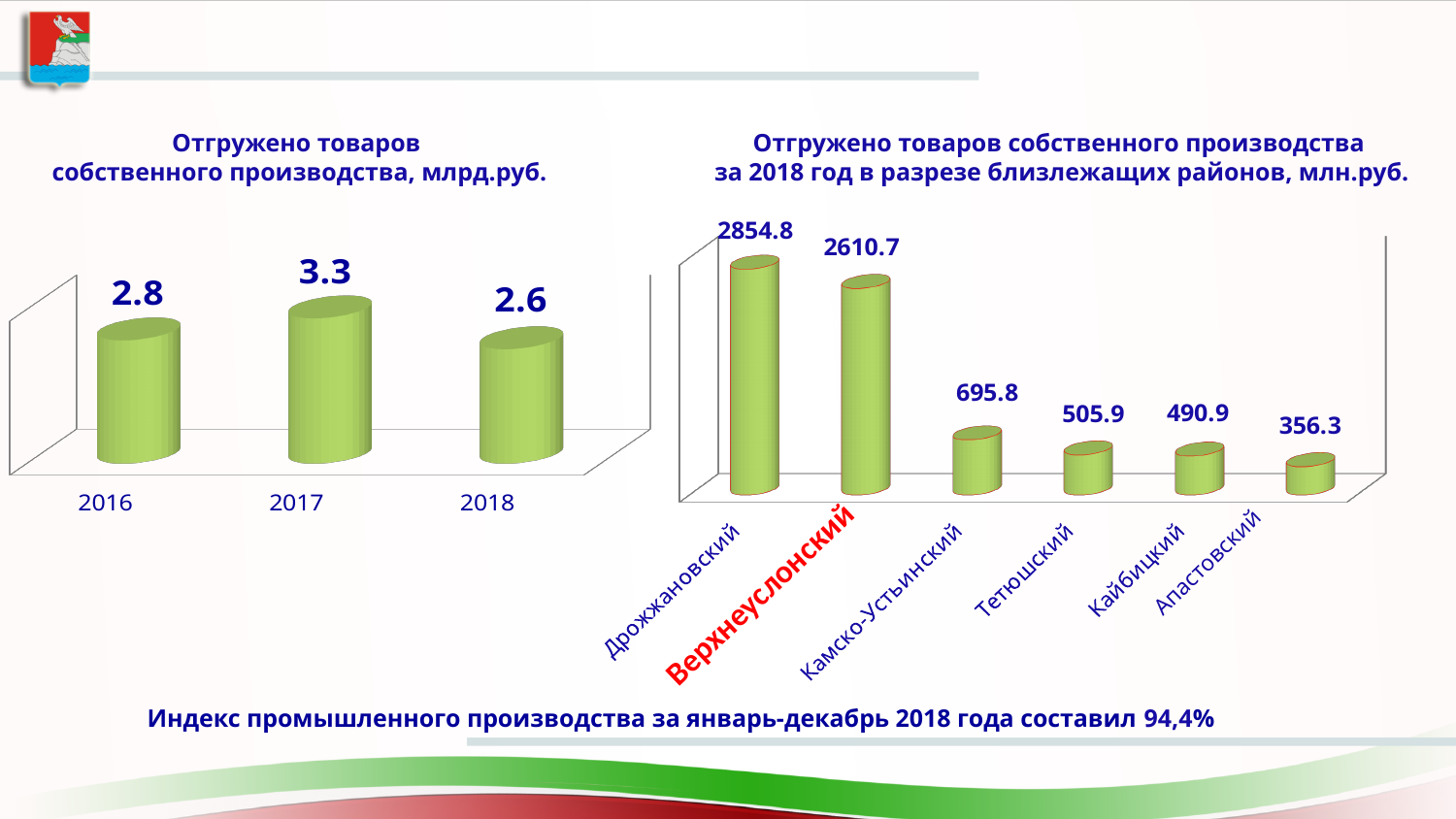
What kind of chart is the right chart (за 2018 год в разрезе близлежащих районов, млн.руб.)? Bar chart In the left chart (Отгружено товаров собственного производства, млрд.руб.), how many years are shown? 3 In the left chart (Отгружено товаров собственного производства, млрд.руб.), what is the value for 2018? 2.6 In the right chart (за 2018 год в разрезе близлежащих районов, млн.руб.), which is larger: Камско-Устьинский or Кайбицкий? Камско-Устьинский In the right chart (за 2018 год в разрезе близлежащих районов, млн.руб.), which district has the highest value? Дрожжановский In the left chart (Отгружено товаров собственного производства, млрд.руб.), what is the value for 2017? 3.3 In the left chart (Отгружено товаров собственного производства, млрд.руб.), what is the difference between the 2017 and 2016 values? 0.5 In the right chart (за 2018 год в разрезе близлежащих районов, млн.руб.), what is the value for Верхнеуслонский? 2610.7 In the right chart (за 2018 год в разрезе близлежащих районов, млн.руб.), how many districts are shown? 6 In the right chart (за 2018 год в разрезе близлежащих районов, млн.руб.), which district has the lowest value? Апастовский In the left chart (Отгружено товаров собственного производства, млрд.руб.), which year has the highest value? 2017 In the right chart (за 2018 год в разрезе близлежащих районов, млн.руб.), what is the value for Тетюшский? 505.9